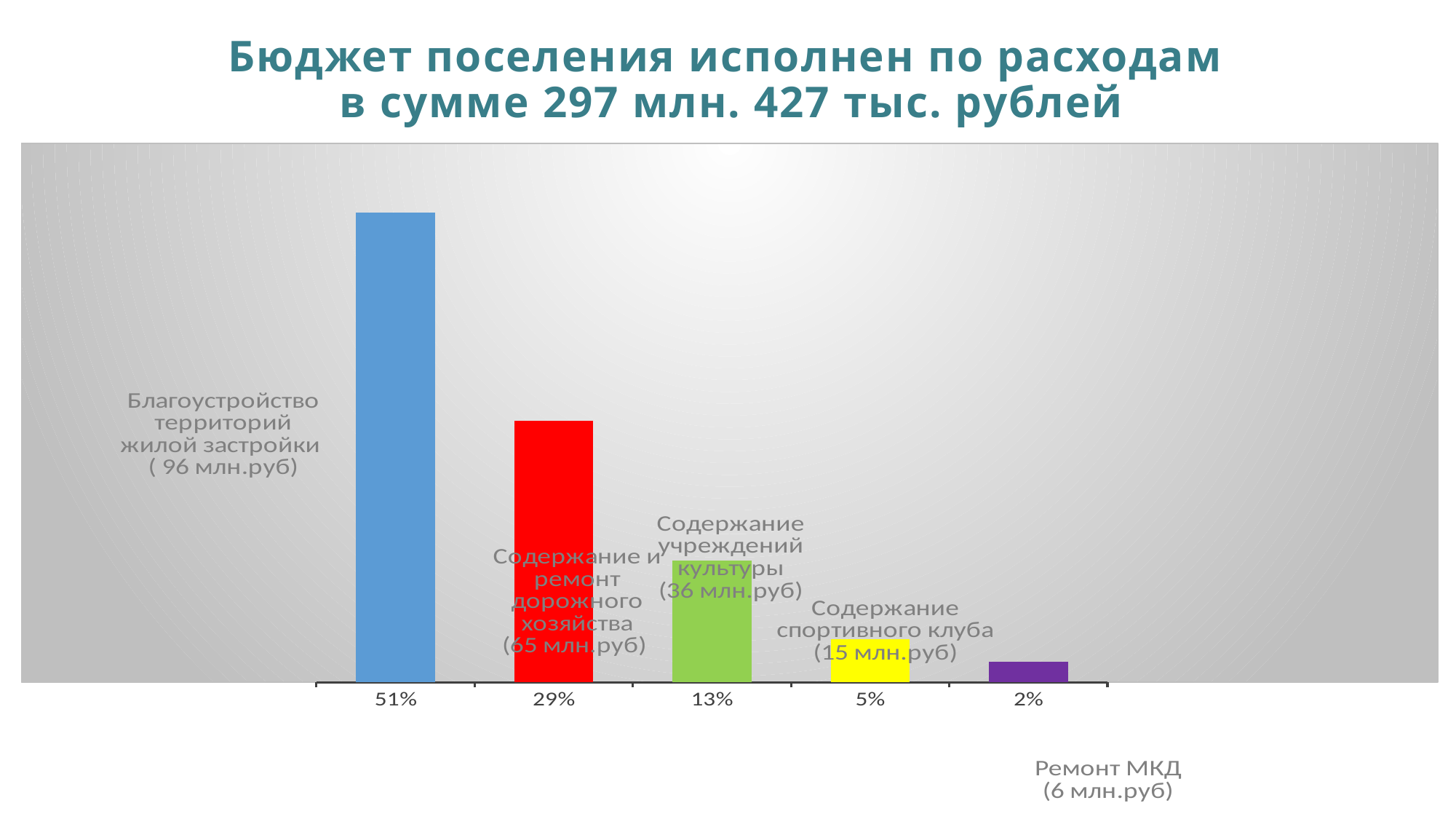
How many bars are plotted in the chart? 5 What percentage share is shown under the bar for Содержание учреждений культуры? 13% What is the difference in percentage points between the shares for Благоустройство территорий жилой застройки (51%) and Содержание и ремонт дорожного хозяйства (29%)? 22 What percentage share is shown under the bar for Благоустройство территорий жилой застройки? 51% What percentage share is shown under the bar for Содержание и ремонт дорожного хозяйства? 29% Which category has the highest bar? Благоустройство территорий жилой застройки Which category has the lowest bar? Ремонт МКД What amount in млн.руб is given for Ремонт МКД? 6 млн.руб What type of chart is shown on the slide? bar chart What amount in млн.руб is given for Содержание спортивного клуба? 15 млн.руб Do the bar values rise or fall from left to right along the x axis? fall Which is larger: the bar for Содержание учреждений культуры or the bar for Содержание спортивного клуба? Содержание учреждений культуры